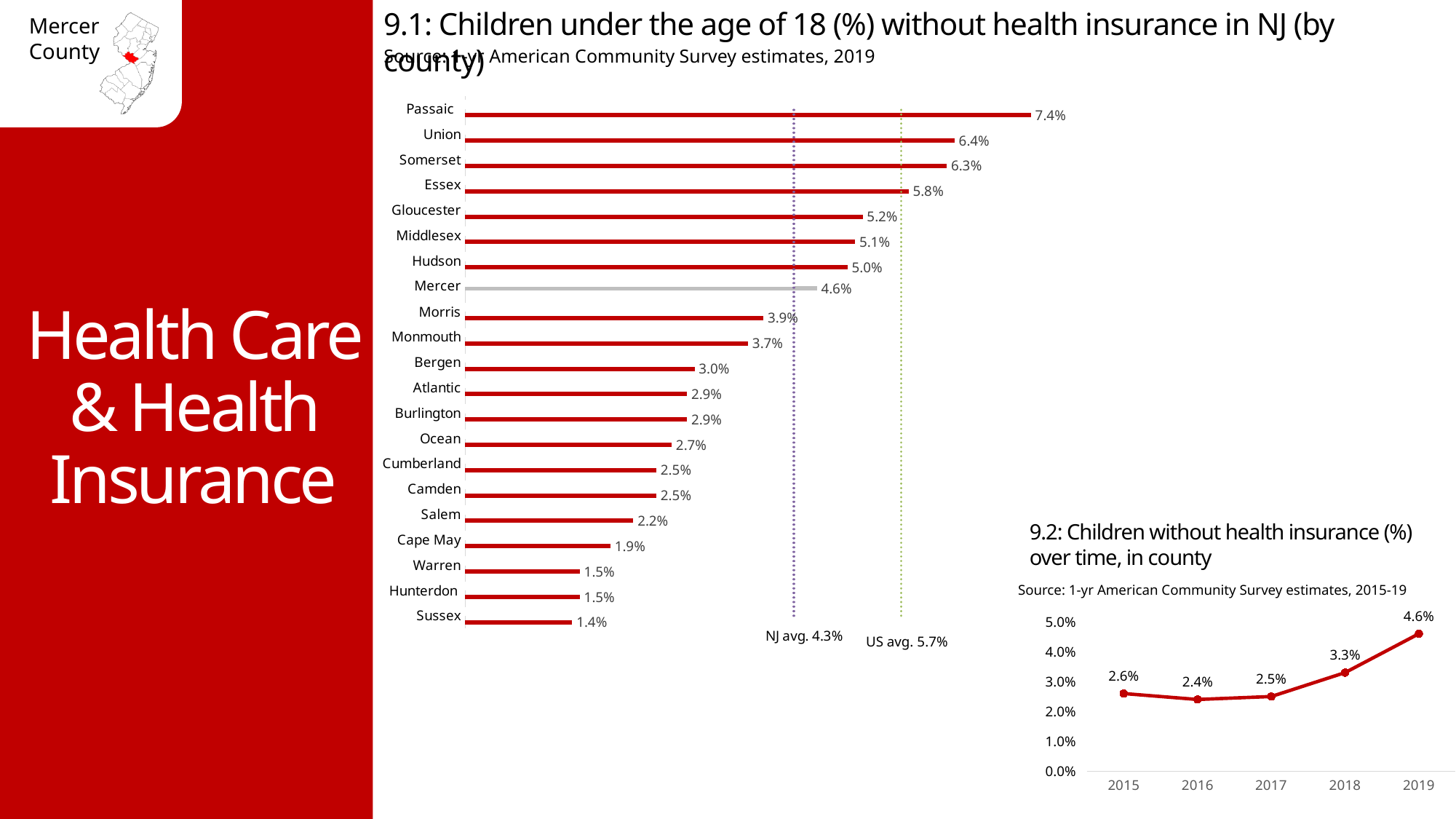
In chart 9.1, what is the NJ average shown by the dotted line? 4.3% In chart 9.1, which county has the lowest percentage of children without health insurance? Sussex In chart 9.1, how many counties are shown? 21 In chart 9.2, do the values rise or fall from 2017 to 2019? Rise In chart 9.2, what is the difference between the values for 2019 and 2015? 2.0% What kind of chart is chart 9.1? Bar chart In chart 9.2, what is the value for 2018? 3.3% In chart 9.1, which county has the highest percentage of children without health insurance? Passaic In chart 9.1, what is the value for Mercer? 4.6% In chart 9.1, which is larger, the value for Union or the value for Essex? Union In chart 9.2, which year has the lowest value? 2016 In chart 9.1, what is the difference between the values for Passaic and Sussex? 6.0%